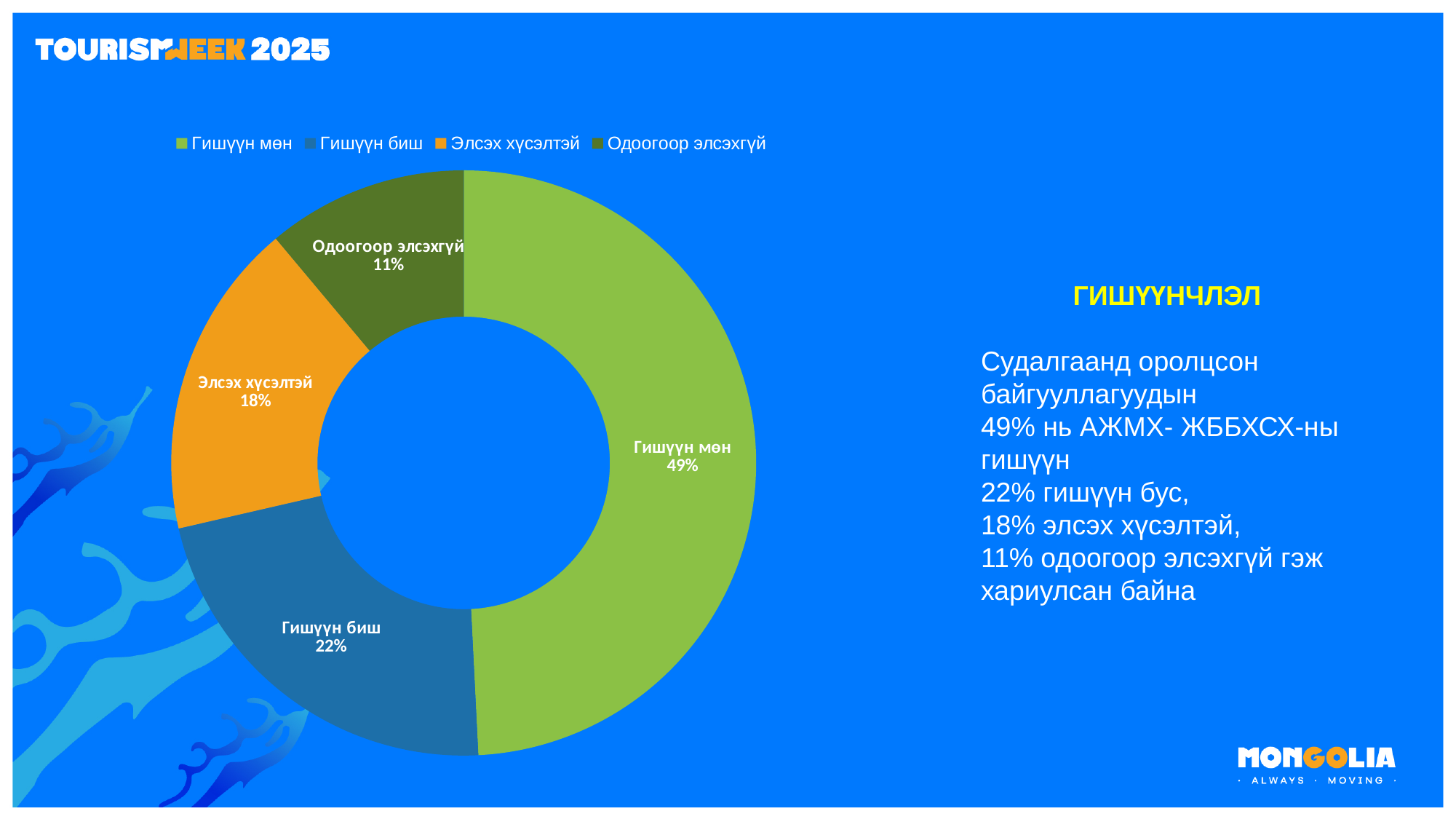
Which category has the largest slice of the pie chart? Гишүүн мөн What percentage is shown for "Одоогоор элсэхгүй"? 11% What percentage of the pie chart is labelled "Гишүүн мөн"? 49% What share does the "Гишүүн биш" slice show? 22% What type of chart is shown on the slide? Pie chart (doughnut) How many entries does the legend list? 4 What is the difference in percentage points between "Гишүүн мөн" and "Гишүүн биш"? 27 Which is larger, the "Элсэх хүсэлтэй" slice or the "Одоогоор элсэхгүй" slice? Элсэх хүсэлтэй How many categories are shown in the pie chart? 4 Which category has the smallest slice of the pie chart? Одоогоор элсэхгүй What colour is the "Элсэх хүсэлтэй" slice? Orange What is the value shown for "Элсэх хүсэлтэй"? 18%